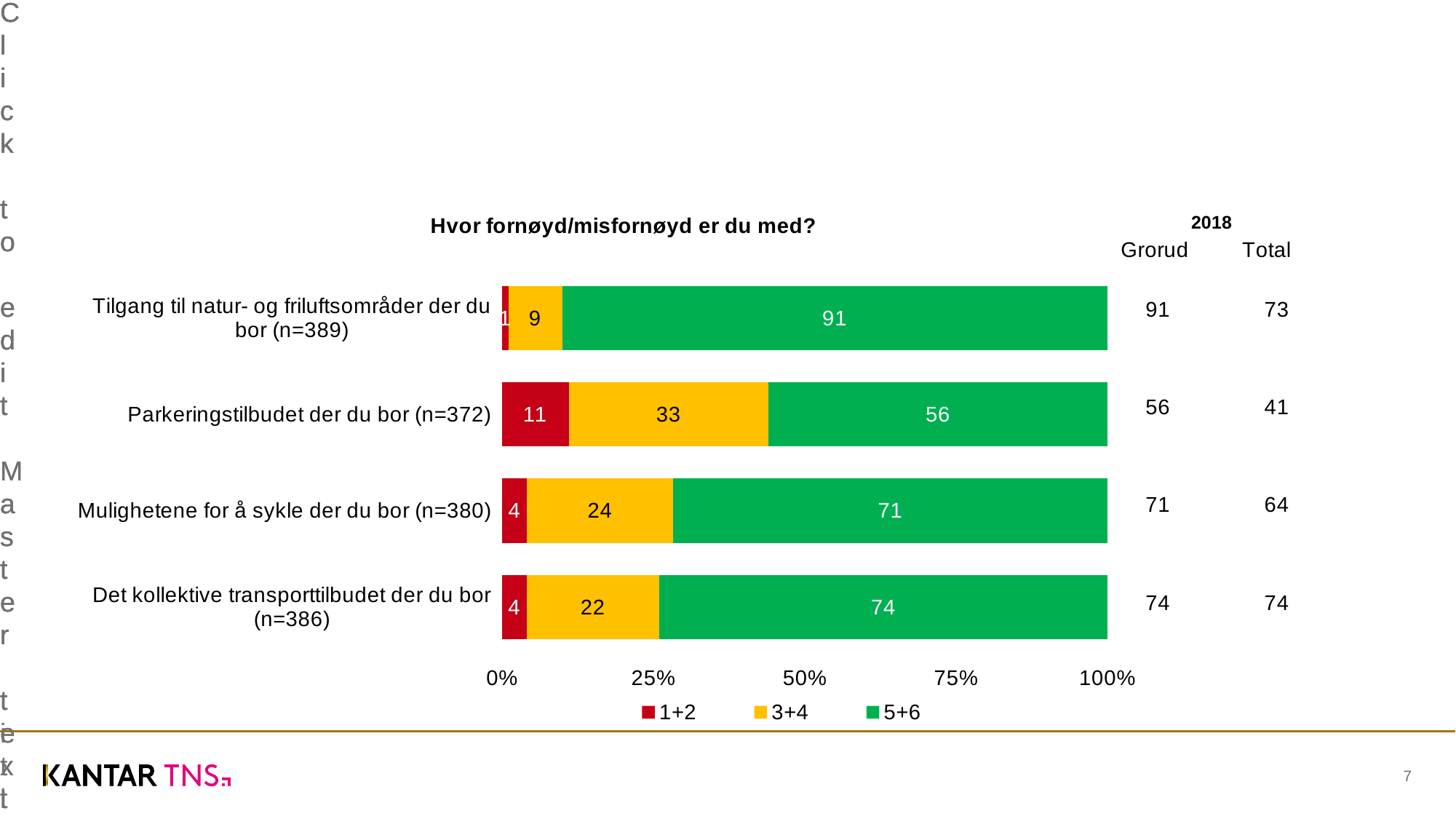
Which category has the highest 5+6 value? Tilgang til natur- og friluftsområder der du bor (n=389) What is the title of the chart? Hvor fornøyd/misfornøyd er du med? What is the 3+4 value for "Mulighetene for å sykle der du bor (n=380)"? 24 What is the 5+6 value for "Parkeringstilbudet der du bor (n=372)"? 56 What is the 1+2 value for "Parkeringstilbudet der du bor (n=372)"? 11 How many categories are shown in the chart? 4 Which is larger: the 3+4 value for "Parkeringstilbudet der du bor (n=372)" or for "Mulighetene for å sykle der du bor (n=380)"? Parkeringstilbudet der du bor (n=372) How many series does the legend list? 3 What kind of chart is shown on the slide? Stacked bar chart What is the 5+6 value for "Det kollektive transporttilbudet der du bor (n=386)"? 74 What is the difference between the 5+6 values for "Tilgang til natur- og friluftsområder der du bor (n=389)" and "Parkeringstilbudet der du bor (n=372)"? 35 Which category has the lowest 5+6 value? Parkeringstilbudet der du bor (n=372)